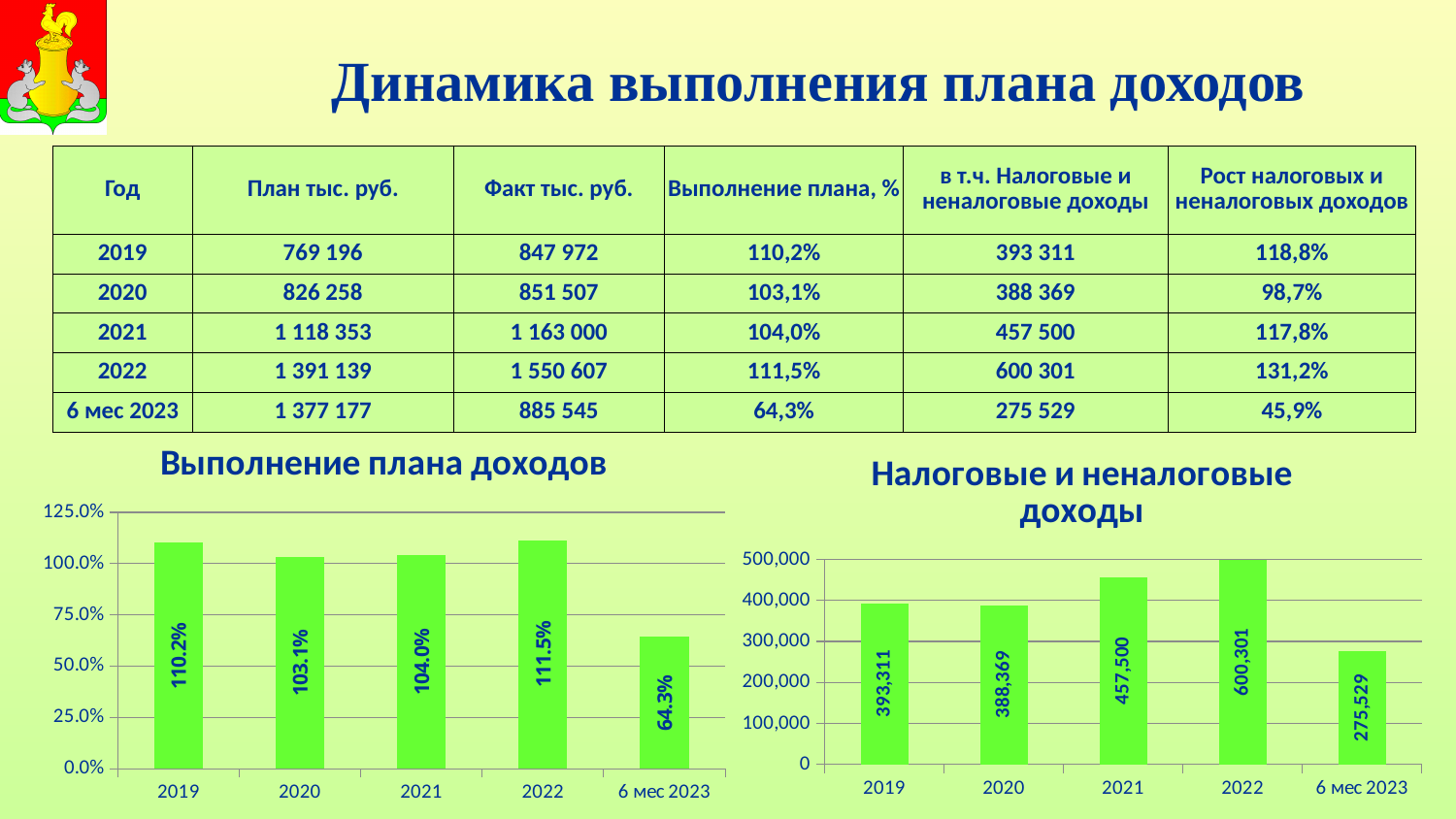
In the chart titled "Налоговые и неналоговые доходы", which is larger, the value for 2019 or the value for 6 мес 2023? 2019 In the chart titled "Выполнение плана доходов", what is the difference between the values for 2019 and 2020? 7.1% In the chart titled "Выполнение плана доходов", which category has the highest value? 2022 In the chart titled "Налоговые и неналоговые доходы", what is the difference between the values for 2022 and 2021? 142,801 In the chart titled "Выполнение плана доходов", what is the value for 6 мес 2023? 64.3% In the chart titled "Выполнение плана доходов", how many categories are shown on the x axis? 5 In the chart titled "Налоговые и неналоговые доходы", what is the value for 2020? 388,369 In the chart titled "Выполнение плана доходов", which category has the lowest value? 6 мес 2023 In the chart titled "Выполнение плана доходов", what is the value for 2022? 111.5% What kind of chart is the chart titled "Налоговые и неналоговые доходы"? bar chart In the chart titled "Налоговые и неналоговые доходы", what is the value for 2021? 457,500 In the chart titled "Налоговые и неналоговые доходы", which category has the highest value? 2022